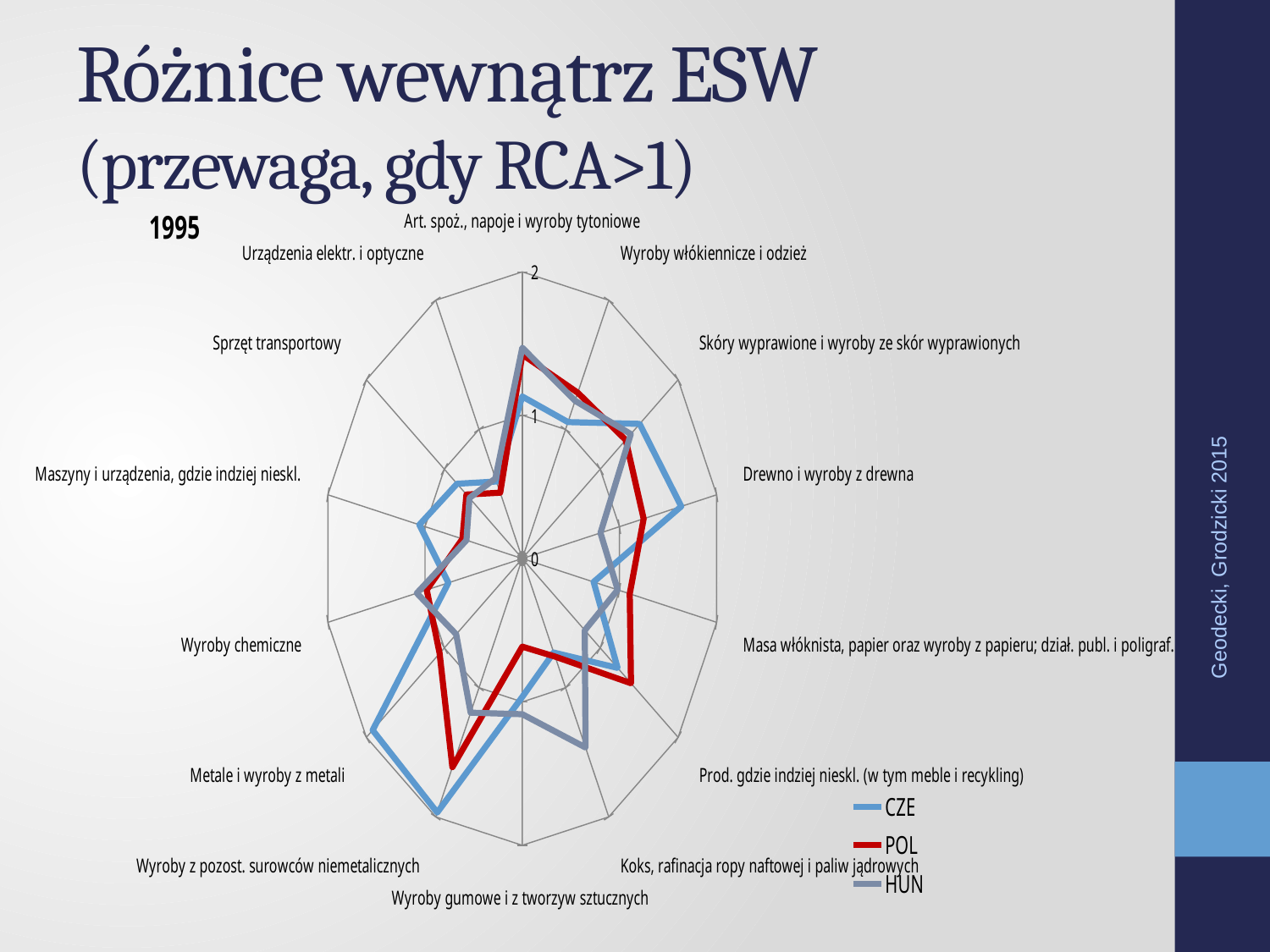
On the 'Wyroby z pozost. surowców niemetalicznych' axis, which series has the larger value, CZE or POL? CZE Is the value for HUN on the 'Maszyny i urządzenia, gdzie indziej nieskl.' axis greater or less than 1? less Is the value for POL on the 'Art. spoż., napoje i wyroby tytoniowe' axis greater or less than 1? greater How many series does the legend list? 3 How many categories (axes) does the radar chart have? 14 Is the value for HUN on the 'Art. spoż., napoje i wyroby tytoniowe' axis greater or less than 1? greater What kind of chart is shown on the slide? radar chart Which year is the chart labelled with? 1995 Which series are listed in the legend? CZE, POL, HUN